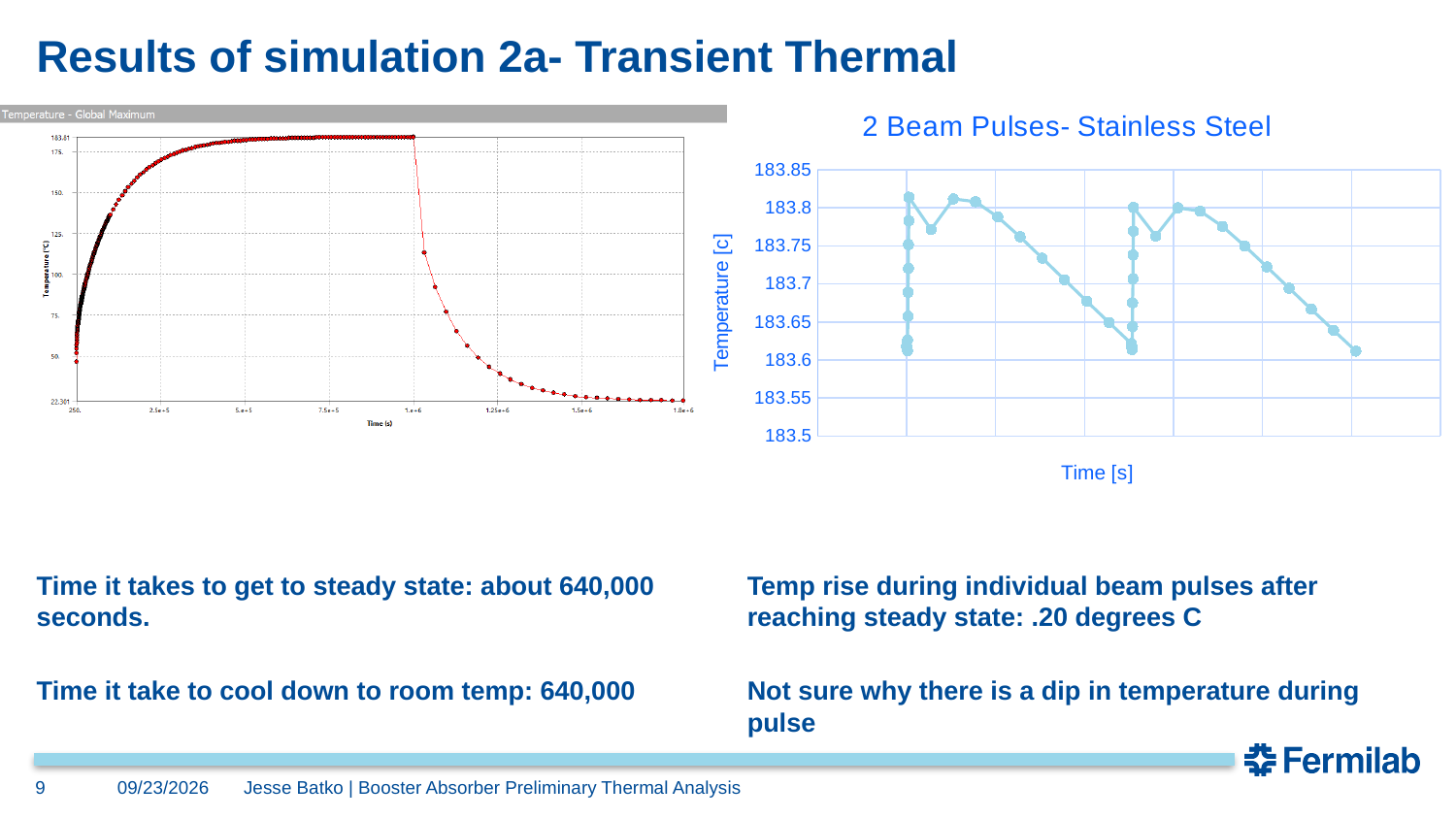
In the 'Temperature - Global Maximum' chart on the left, what is the highest value marked on the temperature axis? 183.81 In the 'Temperature - Global Maximum' chart on the left, does the temperature rise or fall after 1.e+6 s? fall In the '2 Beam Pulses- Stainless Steel' chart, does the temperature rise or fall between the first peak and the start of the second pulse? fall In the '2 Beam Pulses- Stainless Steel' chart, is the lowest plotted temperature greater or less than 183.65? less In the 'Temperature - Global Maximum' chart on the left, what is the lowest value marked on the temperature axis? 22.301 What kind of chart is the '2 Beam Pulses- Stainless Steel' chart on the right? line chart In the '2 Beam Pulses- Stainless Steel' chart, what is the label of the vertical axis? Temperature [c] In the 'Temperature - Global Maximum' chart on the left, does the temperature rise or fall between 250 s and 2.5e+5 s? rise In the 'Temperature - Global Maximum' chart on the left, is the temperature at 1.25e+6 s greater or less than 100? less How many beam pulses (sharp spikes) are shown in the '2 Beam Pulses- Stainless Steel' chart? 2 In the '2 Beam Pulses- Stainless Steel' chart, is the highest plotted temperature greater or less than 183.75? greater What is the title of the chart on the right side of the slide? 2 Beam Pulses- Stainless Steel